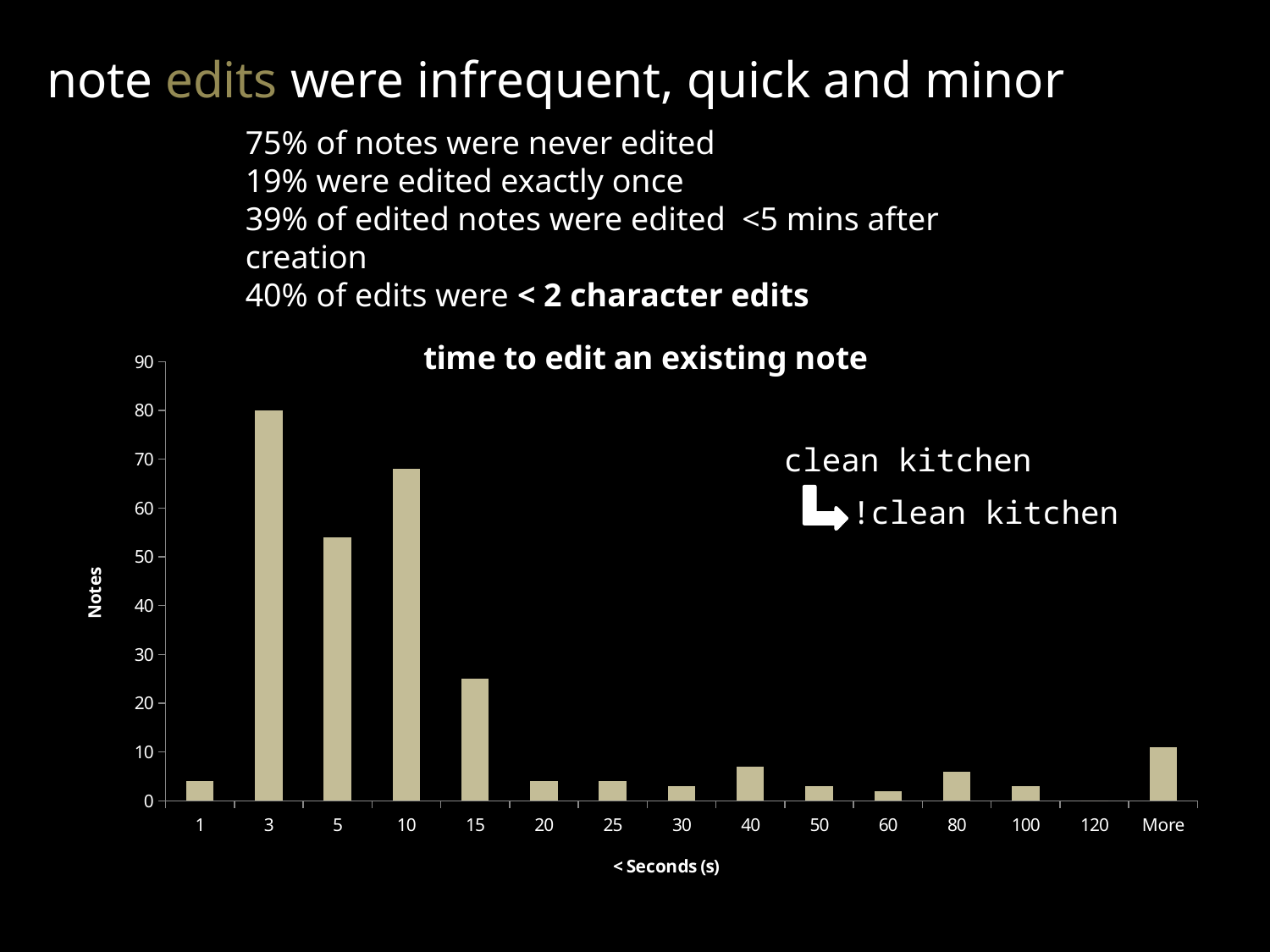
What is the title of the chart? time to edit an existing note Which category on the x axis has no visible bar? 120 Is the value for category 80 greater or less than 10? less What kind of chart is shown on the slide? bar chart Is the value for category 10 greater or less than 60? greater What is the label of the y axis of the chart? Notes Is the value for category 15 greater or less than 30? less Which category has the highest bar in the chart? 3 How many categories are shown on the x axis of the chart? 15 Which has the larger value, category 3 or category 5? 3